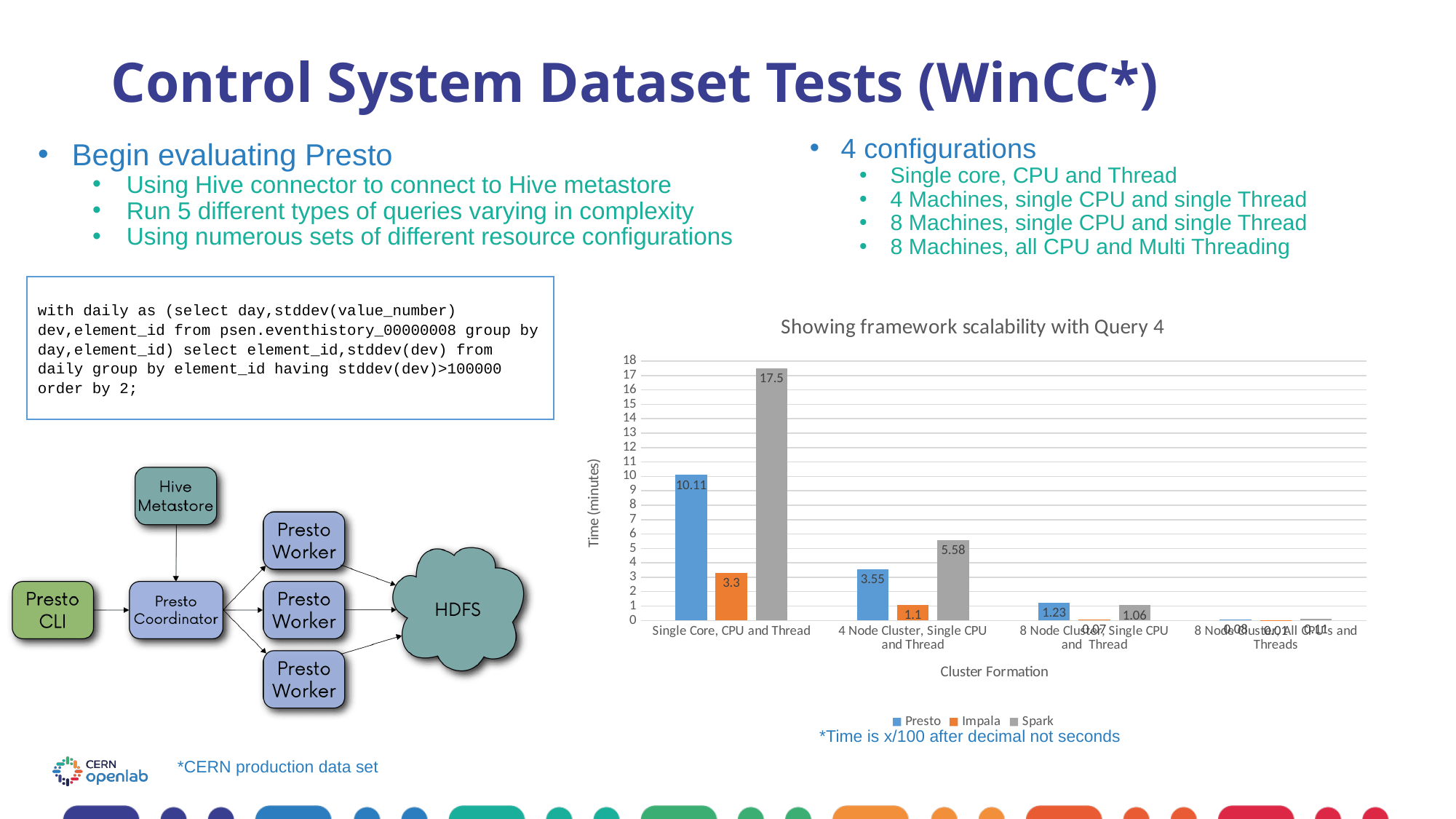
What type of chart is shown on the slide? bar chart What is the title of the chart? Showing framework scalability with Query 4 What is the Presto value for Single Core, CPU and Thread? 10.11 What is the Spark value for Single Core, CPU and Thread? 17.5 What is the difference between the Spark and Presto values for Single Core, CPU and Thread? 7.39 How many series does the chart legend list? 3 Which framework has the highest value for Single Core, CPU and Thread? Spark How many cluster formation categories are shown on the x axis? 4 What is the Impala value for 4 Node Cluster, Single CPU and Thread? 1.1 What is the Presto value for 8 Node Cluster, Single CPU and Thread? 1.23 Do the Presto values rise or fall moving from Single Core to the 8 Node Cluster, All CPUs and Threads configuration? fall Which framework has the lowest value for 4 Node Cluster, Single CPU and Thread? Impala